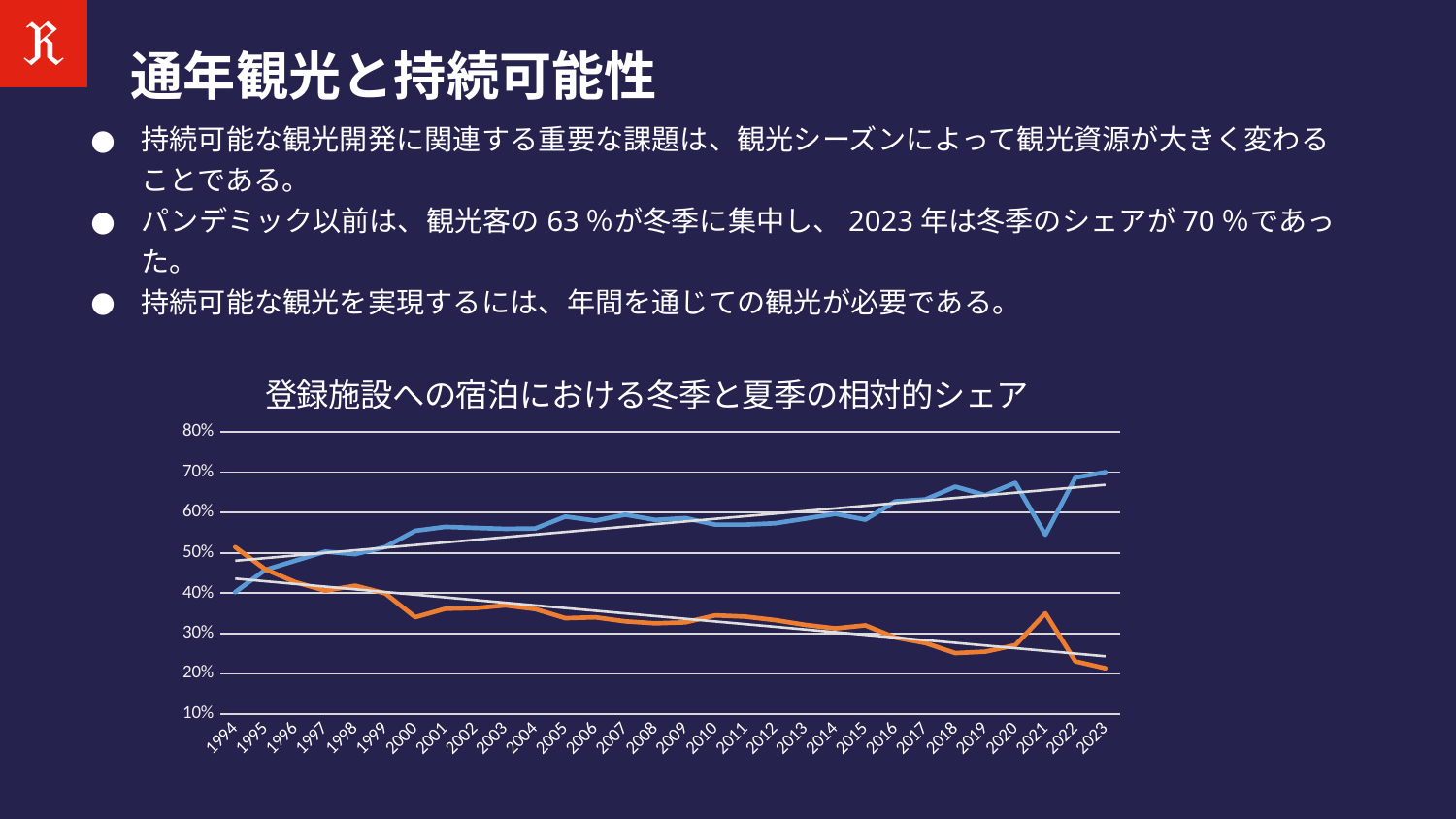
How many years are shown on the x axis of the chart? 30 Does the orange line rise or fall overall from 1994 to 2023? fall What is the title of the chart? 登録施設への宿泊における冬季と夏季の相対的シェア What kind of chart is shown on the slide? line chart Is the value of the orange line in 2018 greater or less than 30%? less In 2023, which line has the higher value, the blue line or the orange line? blue line Does the blue line rise or fall overall from 1994 to 2023? rise Is the value of the orange line in 2023 greater or less than 30%? less Is the value of the blue line in 2021 greater or less than 60%? less In 1994, which line has the higher value, the blue line or the orange line? orange line